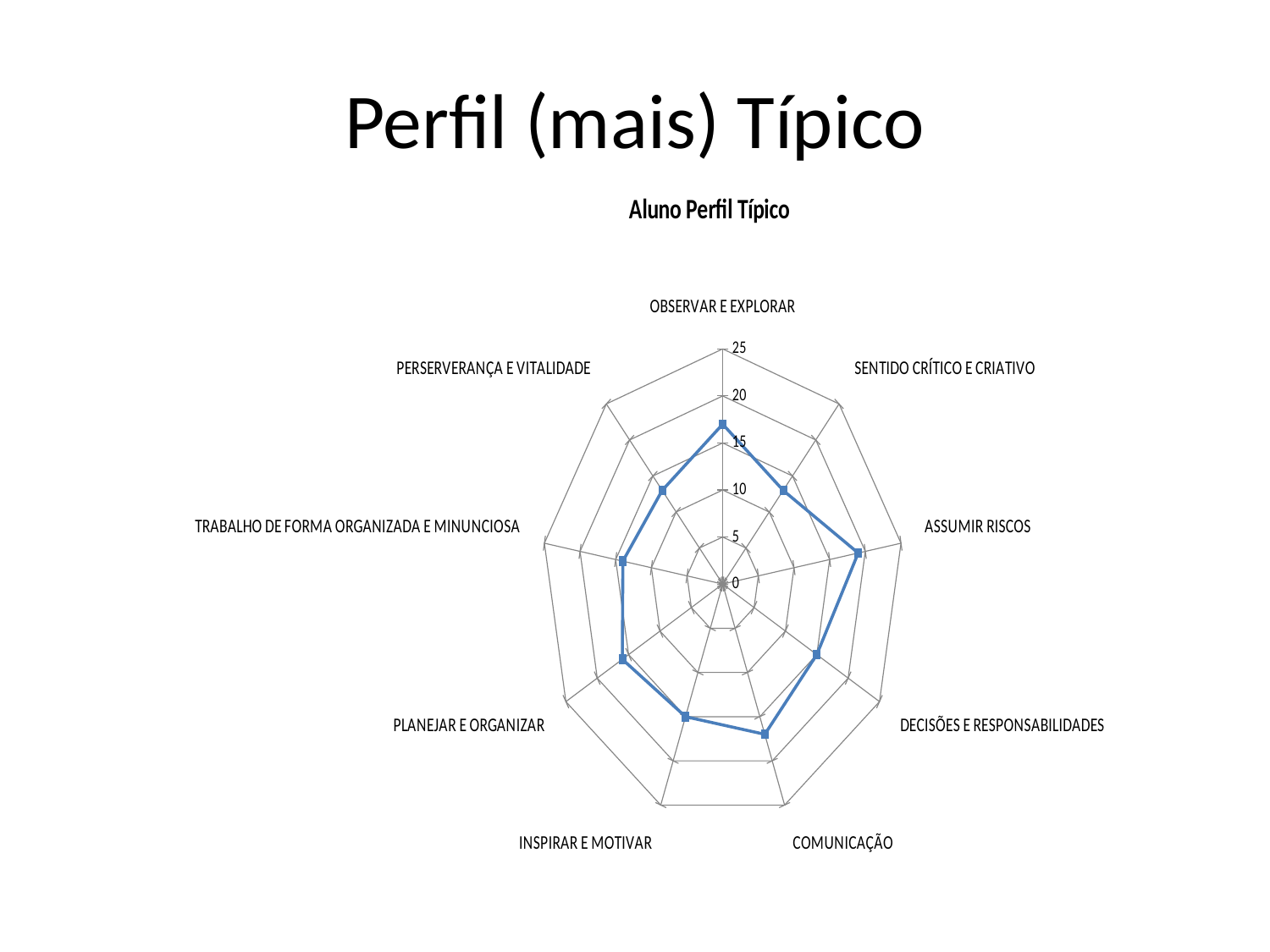
Is the value for OBSERVAR E EXPLORAR greater or less than 20? less Which is larger, the value for ASSUMIR RISCOS or the value for SENTIDO CRÍTICO E CRIATIVO? ASSUMIR RISCOS Is the value for COMUNICAÇÃO greater or less than 15? greater Which category has the highest value in the chart? ASSUMIR RISCOS How many categories (axes) does the radar chart have? 9 Is the value for SENTIDO CRÍTICO E CRIATIVO greater or less than 15? less Which is larger, the value for COMUNICAÇÃO or the value for PERSERVERANÇA E VITALIDADE? COMUNICAÇÃO What kind of chart is shown on the slide? Radar chart What is the maximum value shown on the chart's radial axis? 25 What is the title of the chart? Aluno Perfil Típico